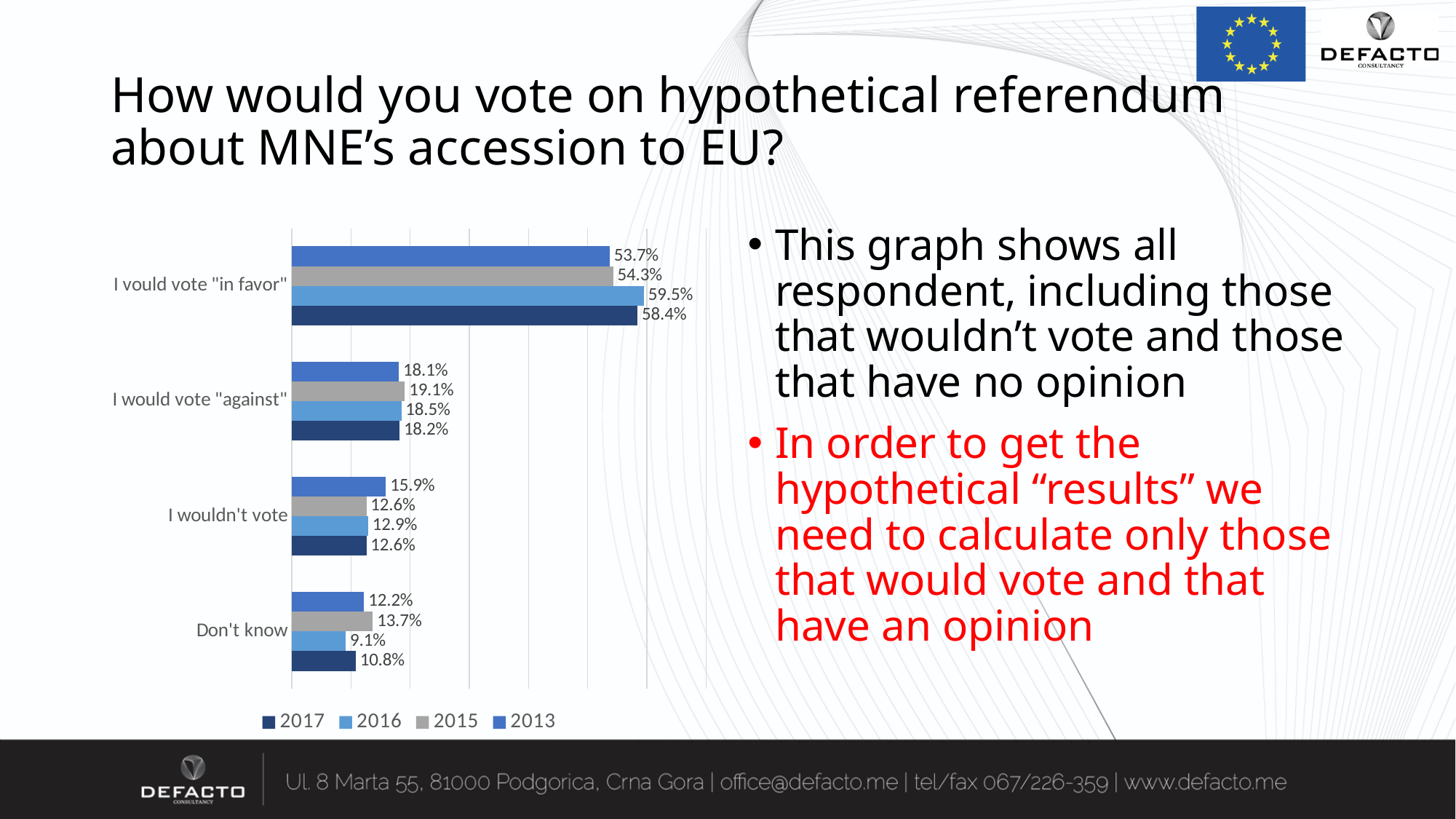
Which year has the lowest value for "Don't know"? 2016 Which is larger for "I wouldn't vote": the 2013 value or the 2017 value? 2013 What is the 2016 value for "I vould vote "in favor""? 59.5% How many response categories are shown on the chart? 4 What type of chart is shown on the slide? bar chart What is the 2016 value for "Don't know"? 9.1% What is the difference between the 2016 and 2013 values for "I vould vote "in favor""? 5.8% Which years are listed in the chart legend? 2017, 2016, 2015, 2013 Which year has the highest value for "I vould vote "in favor""? 2016 How many series does the chart legend list? 4 What is the 2013 value for "I would vote "against""? 18.1% What is the 2017 value for "I vould vote "in favor""? 58.4%